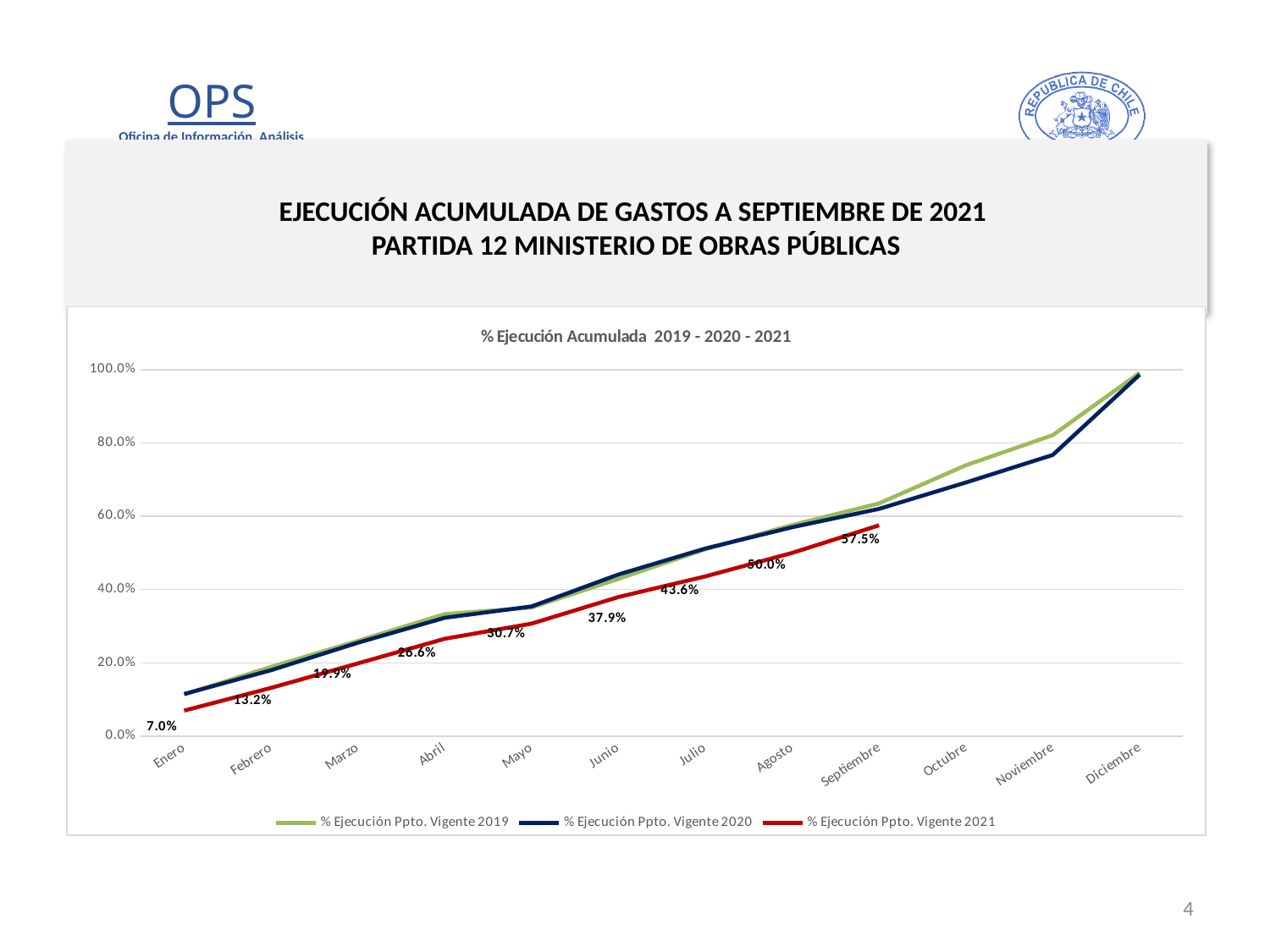
How many series does the legend list? 3 What is the title of the chart? % Ejecución Acumulada 2019 - 2020 - 2021 Which month has the lowest value for % Ejecución Ppto. Vigente 2021? Enero How many months are shown on the x axis? 12 What is the value of % Ejecución Ppto. Vigente 2021 for Mayo? 30.7% Which month has the highest value for % Ejecución Ppto. Vigente 2021? Septiembre What is the difference between the 2021 values for Agosto and Julio? 6.4% Is the value of % Ejecución Ppto. Vigente 2020 for Noviembre greater or less than 80.0%? less What type of chart is shown on the slide? line chart What is the value of % Ejecución Ppto. Vigente 2021 for Enero? 7.0% Do the values of % Ejecución Ppto. Vigente 2021 rise or fall from Enero to Septiembre? rise What is the value of % Ejecución Ppto. Vigente 2021 for Septiembre? 57.5%